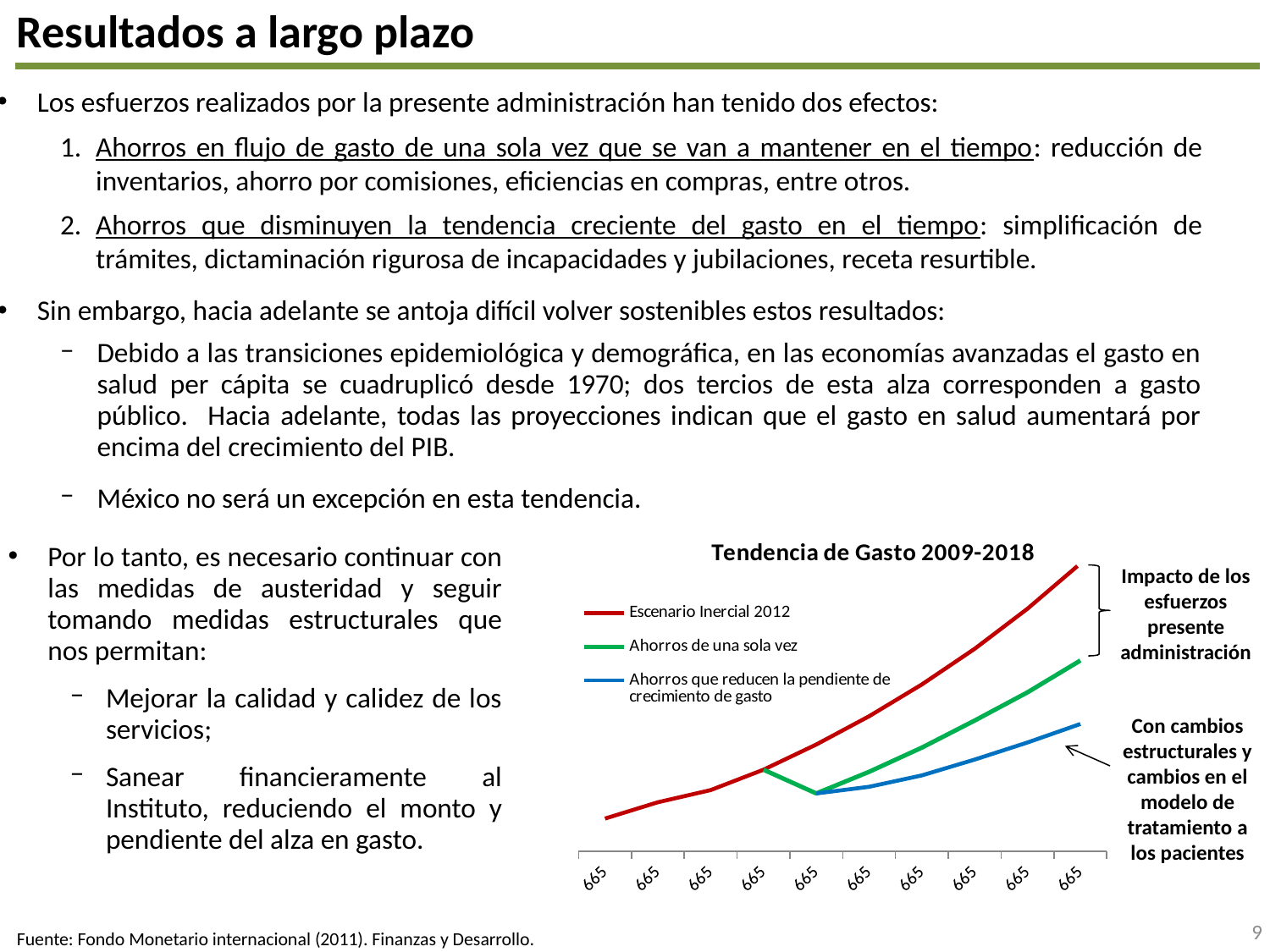
Does the 'Escenario Inercial 2012' line rise or fall along the x axis? Rises Which series is drawn in red in the chart? Escenario Inercial 2012 What type of chart is shown on the slide? Line chart Which series ends at the lowest point on the right side of the chart? Ahorros que reducen la pendiente de crecimiento de gasto How many series does the chart's legend list? 3 Does the 'Ahorros que reducen la pendiente de crecimiento de gasto' line rise or fall toward the right end of the chart? Rises How many tick labels are shown along the x axis of the chart? 10 At the right end of the chart, which is higher: 'Ahorros de una sola vez' or 'Ahorros que reducen la pendiente de crecimiento de gasto'? Ahorros de una sola vez What is the title of the chart on the slide? Tendencia de Gasto 2009-2018 Which series ends at the highest point on the right side of the chart? Escenario Inercial 2012